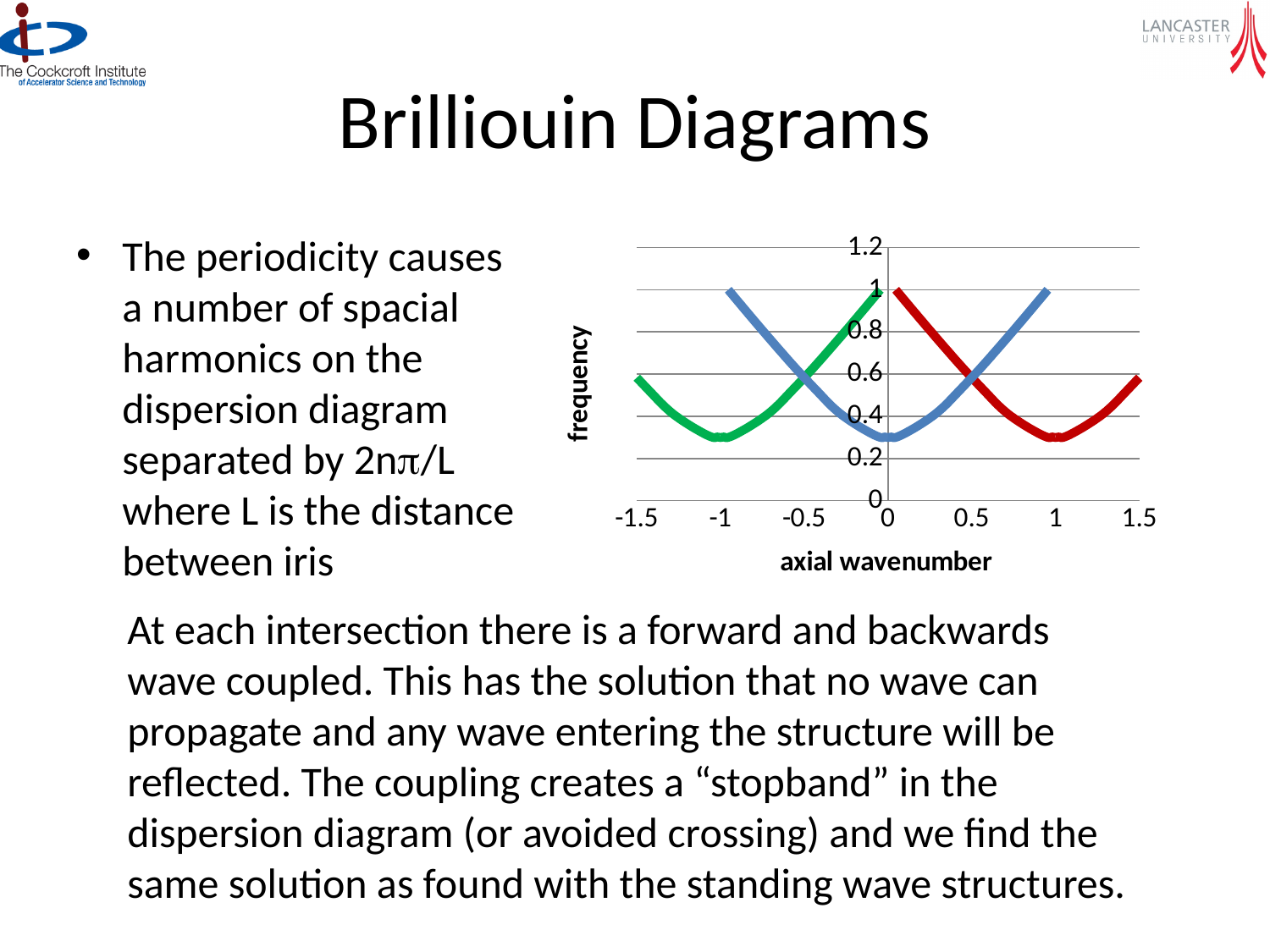
What is the title of the x axis of the chart? axial wavenumber Does the red curve rise or fall as the axial wavenumber increases from 0 to 1? fall Is the value of the blue curve at axial wavenumber -1 greater or less than 0.8? greater What kind of chart is shown on the slide? line chart Is the value of the blue curve at axial wavenumber 0 greater or less than 0.4? less Is the value of the green curve at axial wavenumber -1.5 greater or less than 0.4? greater What is the title of the y axis of the chart? frequency How many curves are plotted on the chart? 3 Does the blue curve rise or fall as the axial wavenumber increases from 0 to 1? rise Does the green curve rise or fall as the axial wavenumber increases from -1.5 to -1? fall